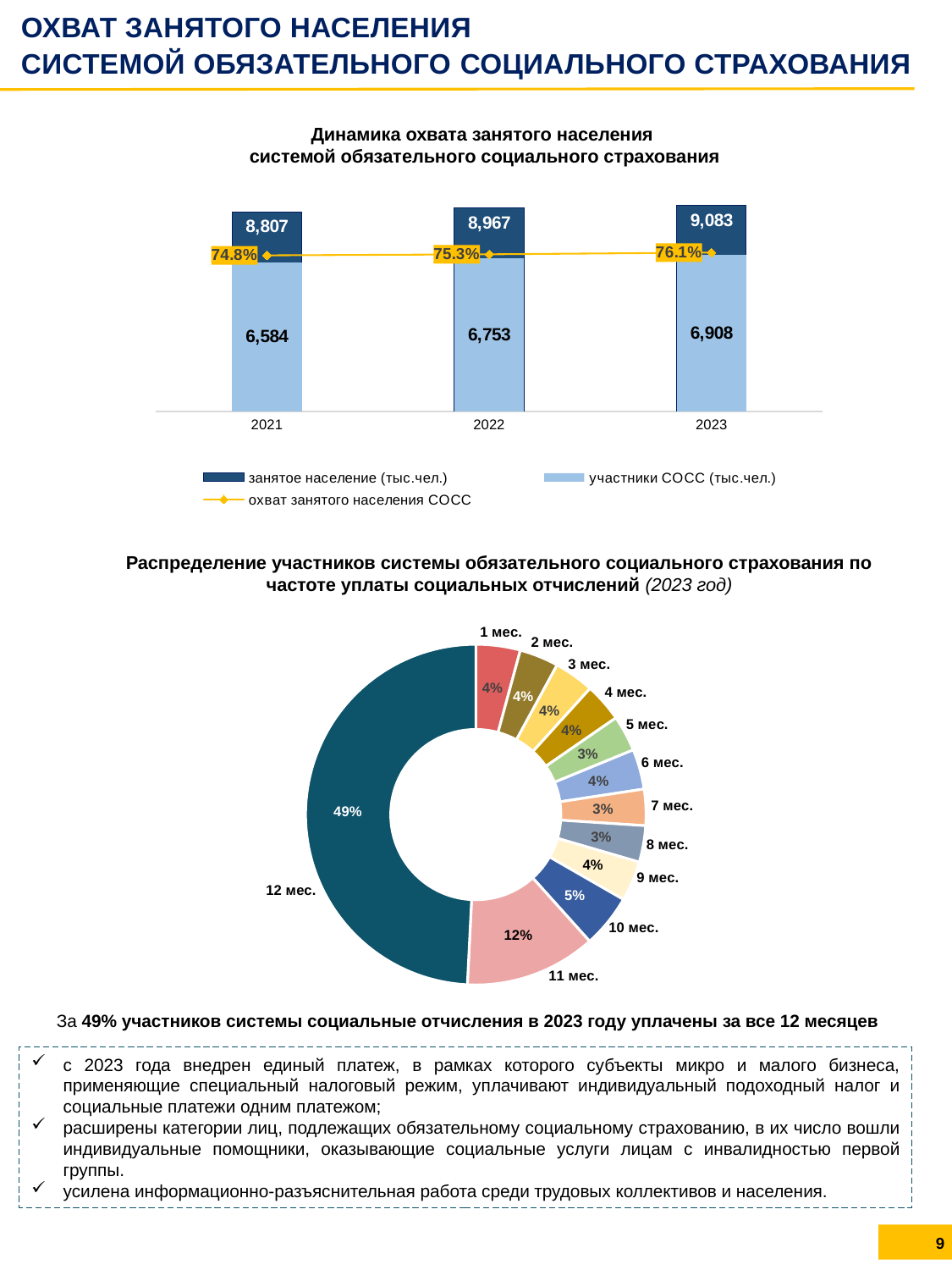
What kind of chart is the bottom chart? Donut (pie) chart In the bottom chart, which category has the largest share? 12 мес. In the top chart, how many series does the legend list? 3 In the top chart, what is the 'охват занятого населения СОСС' value for 2022? 75.3% In the bottom chart 'Распределение участников системы обязательного социального страхования по частоте уплаты социальных отчислений (2023 год)', what share does '12 мес.' have? 49% In the top chart, does the 'участники СОСС' value rise or fall from 2021 to 2023? rise In the top chart, what is the value for 'участники СОСС (тыс.чел.)' in 2021? 6,584 In the top chart, what is the difference between 'занятое население' and 'участники СОСС' in 2022? 2,214 In the top chart, how many years are shown on the x axis? 3 In the bottom chart, which is larger: the share for '10 мес.' or the share for '8 мес.'? 10 мес. In the bottom chart, what is the share for '11 мес.'? 12% In the top chart 'Динамика охвата занятого населения системой обязательного социального страхования', what is the value for 'занятое население (тыс.чел.)' in 2023? 9,083